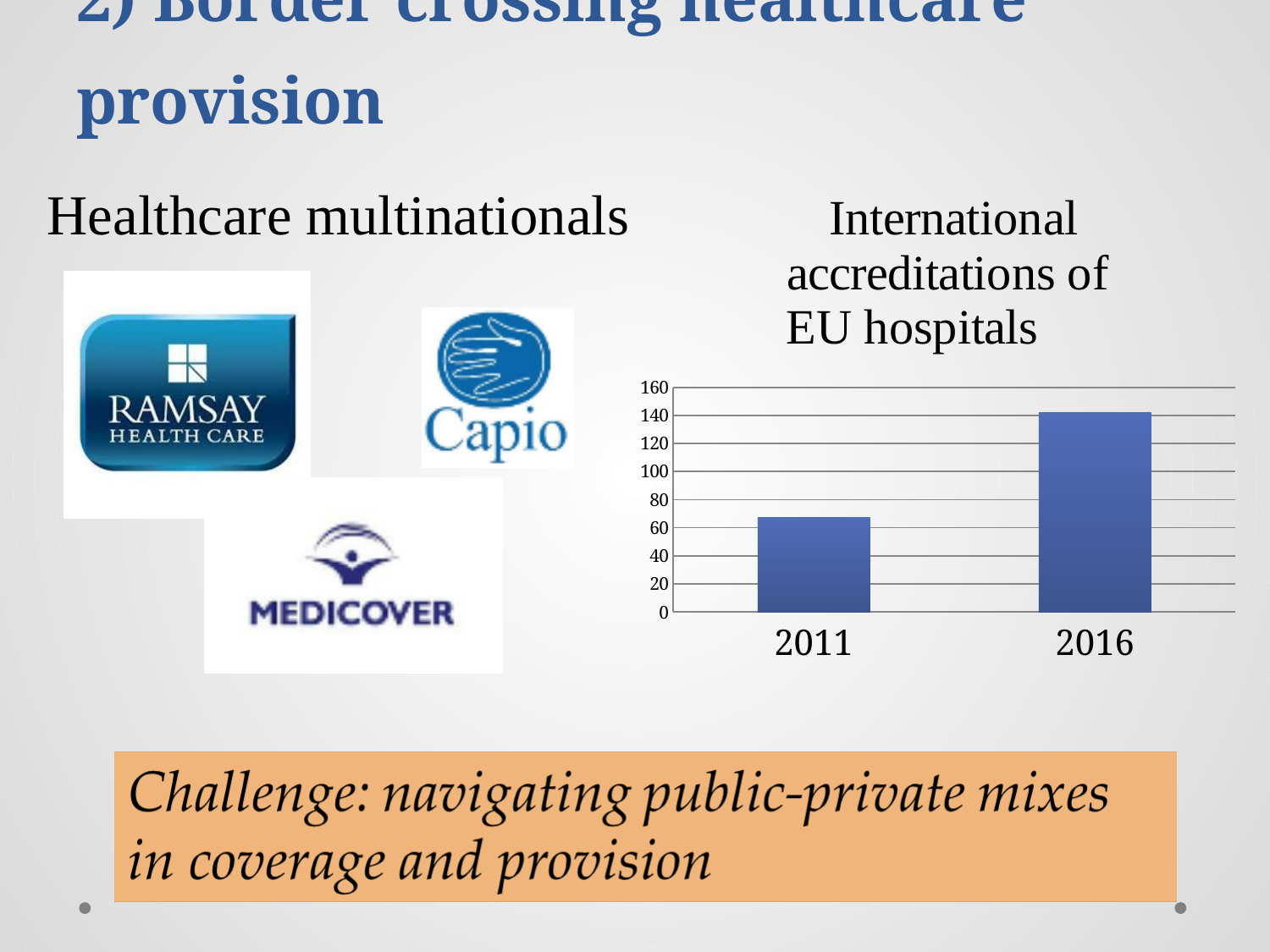
Which year has the higher bar in the chart? 2016 Which year has the lower bar in the chart? 2011 Is the bar for 2011 greater or less than 80? less Do the values rise or fall from 2011 to 2016? rise Is the bar for 2011 greater or less than 60? greater How many categories are plotted on the x axis of the chart? 2 What kind of chart is shown under the heading "International accreditations of EU hospitals"? bar chart What is the highest value shown on the chart's vertical axis? 160 Is the value for 2016 larger or smaller than the value for 2011? larger Is the bar for 2016 greater or less than 160? less What is the title of the chart on the slide? International accreditations of EU hospitals